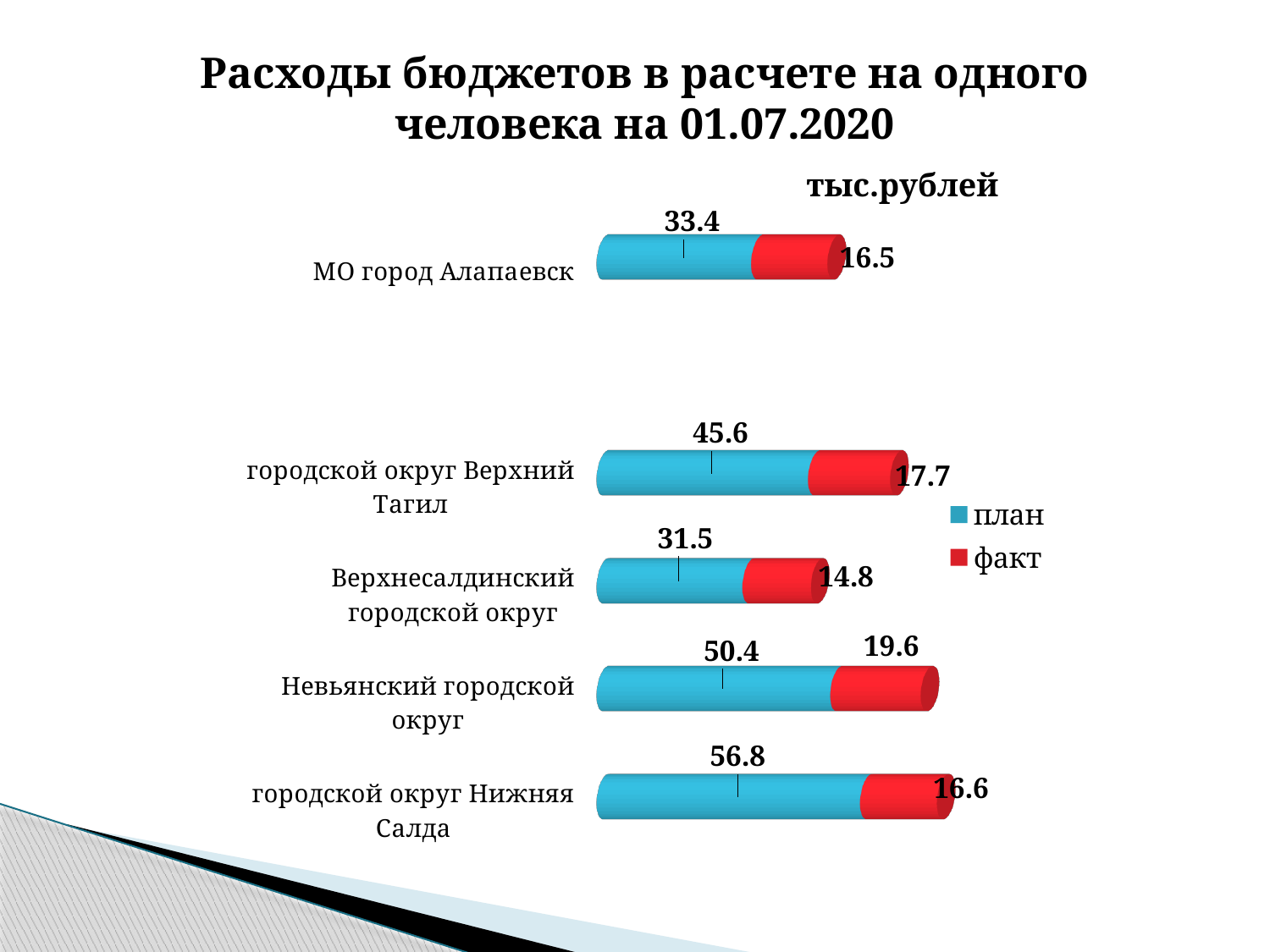
What type of chart is shown on the slide? Bar chart Which category has the highest факт value? Невьянский городской округ What is the факт value for МО город Алапаевск? 16.5 What is the план value for городской округ Нижняя Салда? 56.8 What is the план value for Невьянский городской округ? 50.4 How many categories are shown in the chart? 5 Which is larger: the план value for МО город Алапаевск or the план value for Верхнесалдинский городской округ? МО город Алапаевск What is the факт value for Верхнесалдинский городской округ? 14.8 What is the difference between the план and факт values for городской округ Верхний Тагил? 27.9 How many series does the legend list? 2 Which category has the highest план value? городской округ Нижняя Салда Which category has the lowest факт value? Верхнесалдинский городской округ